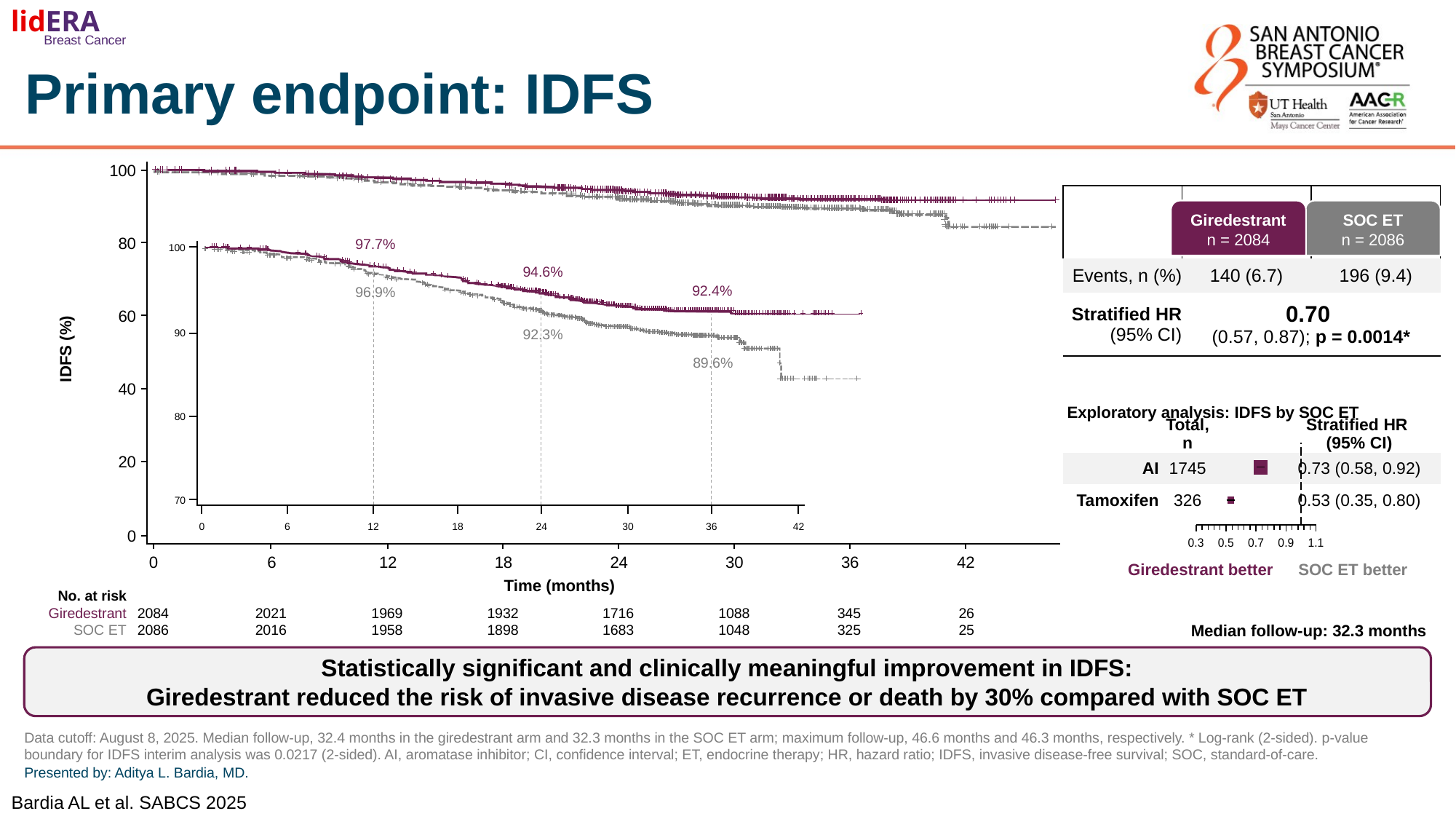
In the number-at-risk table below the Kaplan-Meier chart, how many giredestrant patients were at risk at 30 months? 1088 In the Kaplan-Meier chart, what is the IDFS rate for SOC ET at 36 months? 89.6% In the number-at-risk table below the Kaplan-Meier chart, how many SOC ET patients were at risk at 0 months? 2086 In the forest plot on the right, which subgroup has the lower stratified hazard ratio, AI or tamoxifen? Tamoxifen In the forest plot on the right, what is the stratified HR (95% CI) for the tamoxifen subgroup? 0.53 (0.35, 0.80) In the Kaplan-Meier chart, what is the difference between the giredestrant and SOC ET IDFS rates at 36 months? 2.8 percentage points How many treatment arms are plotted in the Kaplan-Meier chart? 2 In the Kaplan-Meier chart, what is the difference between the giredestrant and SOC ET IDFS rates at 12 months? 0.8 percentage points In the Kaplan-Meier chart, do the IDFS curves rise or fall as time increases? Fall In the Kaplan-Meier chart, which arm has the higher IDFS rate at 36 months? Giredestrant What kind of chart is the main plot on the left of the slide? Kaplan-Meier survival curve (line chart) In the Kaplan-Meier chart, what is the IDFS rate for giredestrant at 24 months? 94.6%